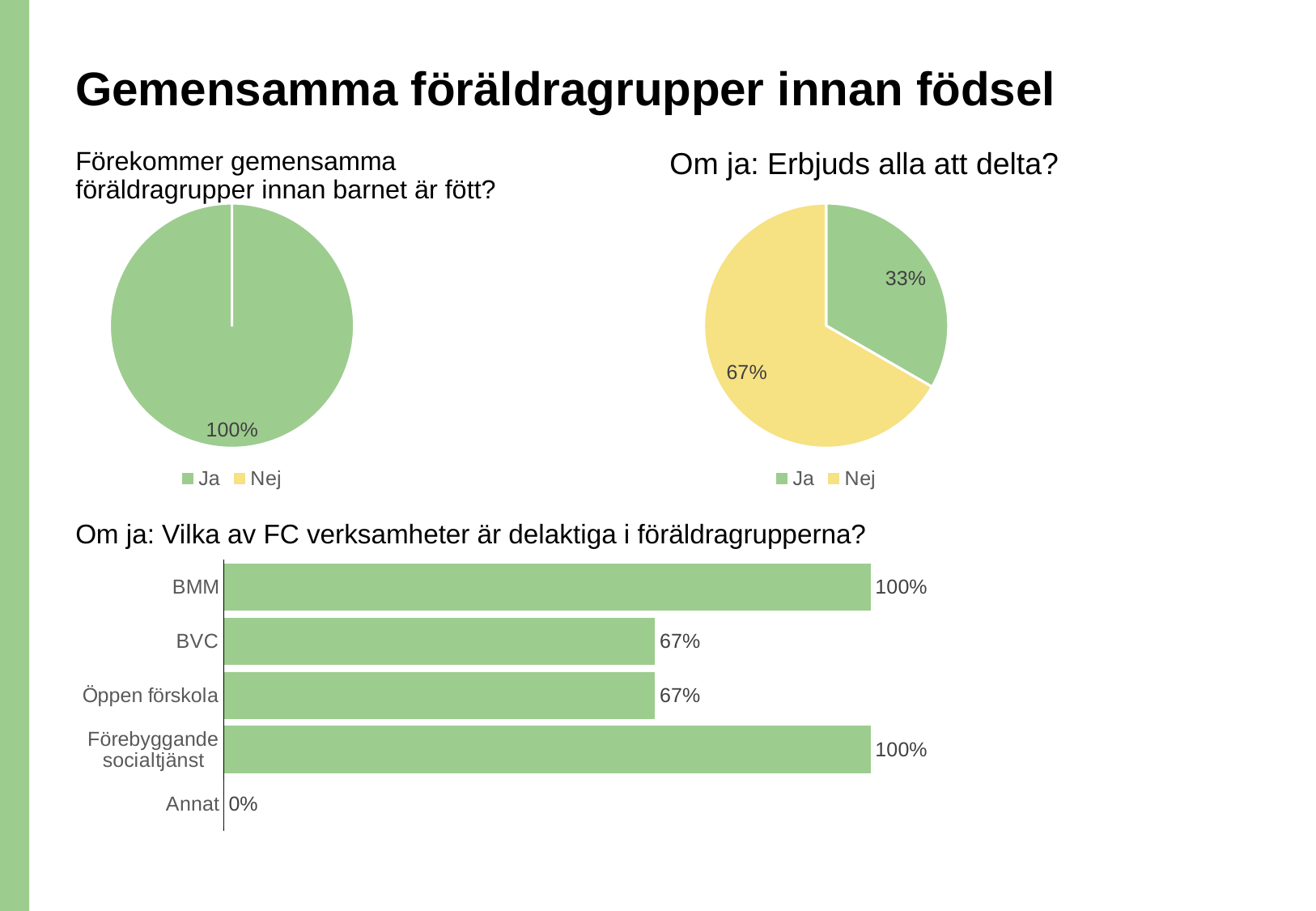
In the pie chart titled "Om ja: Erbjuds alla att delta?", which slice is larger, Ja or Nej? Nej In the chart titled "Om ja: Vilka av FC verksamheter är delaktiga i föräldragrupperna?", what is the difference between BMM and Öppen förskola? 33% In the chart titled "Om ja: Vilka av FC verksamheter är delaktiga i föräldragrupperna?", what is the value for Förebyggande socialtjänst? 100% What kind of chart is the one titled "Om ja: Vilka av FC verksamheter är delaktiga i föräldragrupperna?"? Bar chart In the pie chart titled "Förekommer gemensamma föräldragrupper innan barnet är fött?", what share does Ja have? 100% In the chart titled "Om ja: Vilka av FC verksamheter är delaktiga i föräldragrupperna?", which category has the lowest value? Annat In the pie chart titled "Om ja: Erbjuds alla att delta?", what colour is the Nej slice? Yellow In the pie chart titled "Förekommer gemensamma föräldragrupper innan barnet är fött?", how many entries does the legend list? 2 In the pie chart titled "Om ja: Erbjuds alla att delta?", what share does Ja have? 33% In the chart titled "Om ja: Vilka av FC verksamheter är delaktiga i föräldragrupperna?", what is the value for BVC? 67% In the chart titled "Om ja: Vilka av FC verksamheter är delaktiga i föräldragrupperna?", how many categories are shown? 5 In the pie chart titled "Om ja: Erbjuds alla att delta?", what share does Nej have? 67%